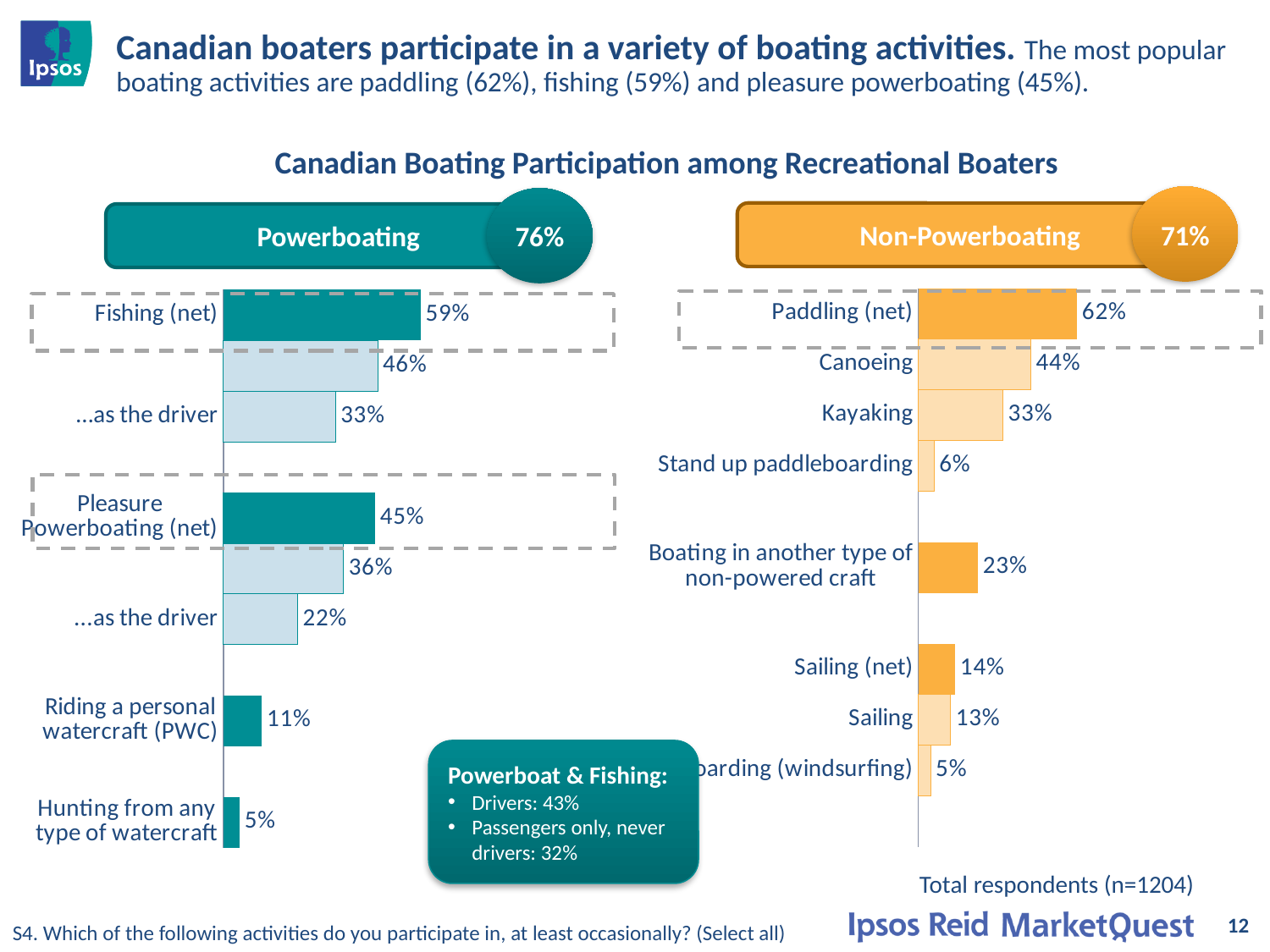
In the Powerboating chart, what is the value for Fishing (net)? 59% In the Powerboating chart, which category has the lowest value? Hunting from any type of watercraft In the Non-Powerboating chart, what is the value for Boating in another type of non-powered craft? 23% In the Non-Powerboating chart, what is the value for Kayaking? 33% Which is larger: Fishing (net) in the Powerboating chart or Paddling (net) in the Non-Powerboating chart? Paddling (net) What overall percentage is shown in the Non-Powerboating header circle? 71% In the Powerboating chart, what is the value for Riding a personal watercraft (PWC)? 11% In the Non-Powerboating chart, which is larger: Stand up paddleboarding or Sailing (net)? Sailing (net) What type of chart is used on this slide? Bar chart In the Powerboating chart, what is the difference between Fishing (net) and Pleasure Powerboating (net)? 14% In the Non-Powerboating chart, which category has the highest value? Paddling (net) In the Non-Powerboating chart, what is the difference between Canoeing and Kayaking? 11%